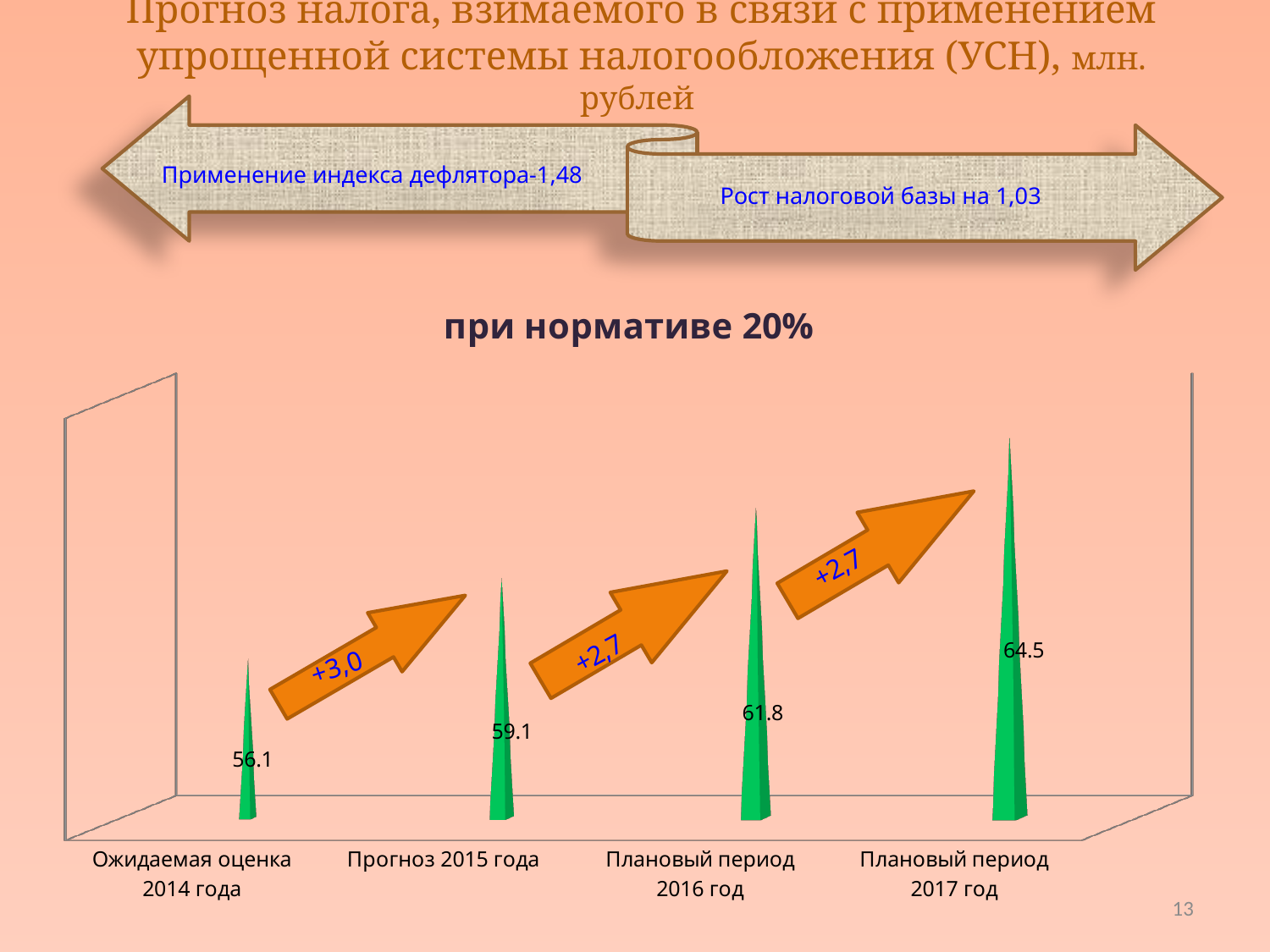
What is the value for Прогноз 2015 года? 59.1 What increase is shown on the arrow between Плановый период 2016 год and Плановый период 2017 год? +2,7 What is the difference between the values for Плановый период 2017 год and Ожидаемая оценка 2014 года? 8.4 Which is larger, the value for Плановый период 2016 год or the value for Прогноз 2015 года? Плановый период 2016 год What is the value for Плановый период 2017 год? 64.5 What is the value for Ожидаемая оценка 2014 года? 56.1 Do the values rise or fall from left to right along the x axis? rise Which category has the highest value? Плановый период 2017 год What is the difference between the values for Прогноз 2015 года and Ожидаемая оценка 2014 года? 3.0 How many categories are shown in the chart? 4 Which category has the lowest value? Ожидаемая оценка 2014 года What is the value for Плановый период 2016 год? 61.8